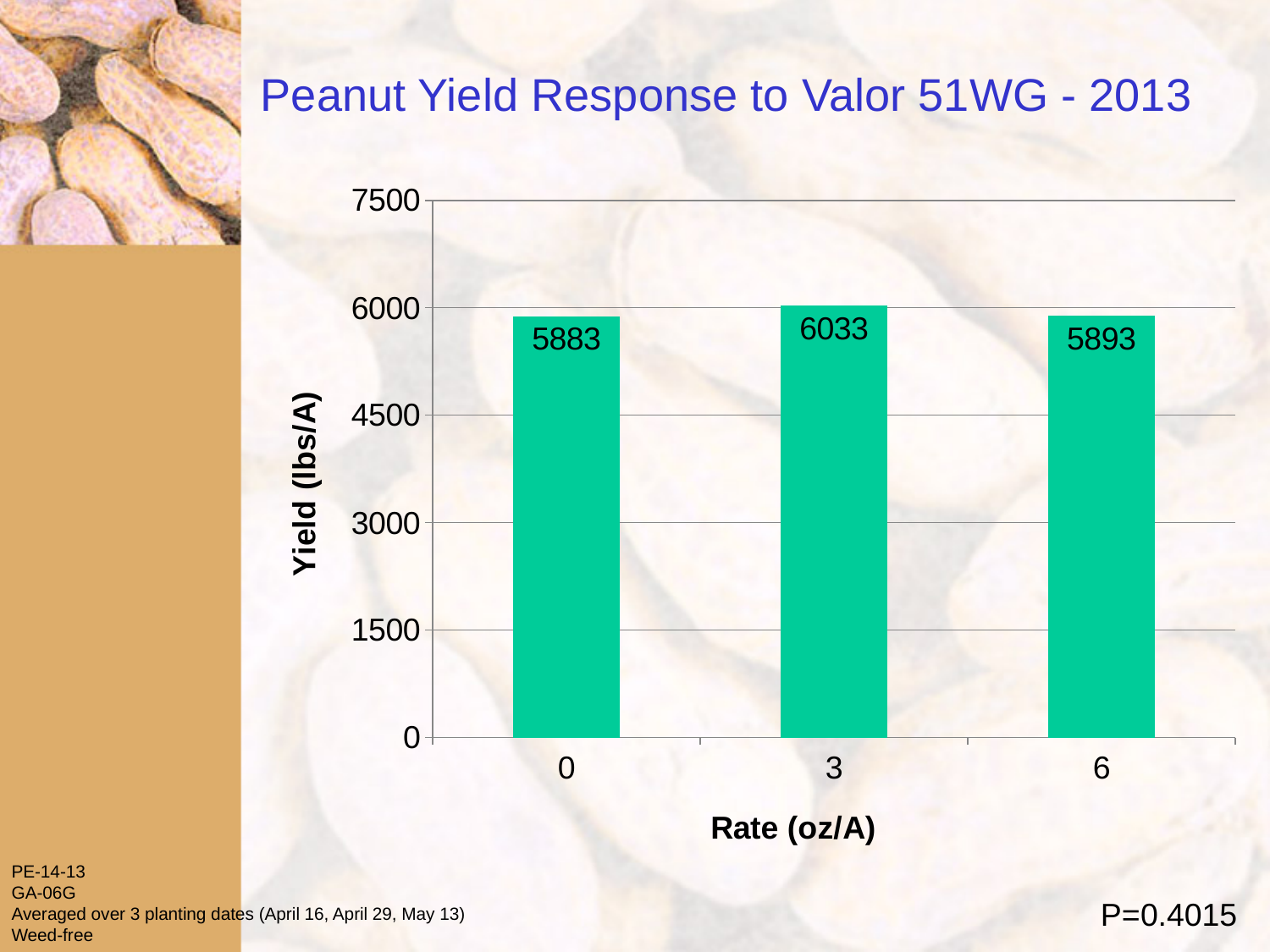
What kind of chart is shown on the slide? bar chart What is the yield at a rate of 3 oz/A? 6033 What is the difference in yield between the 3 oz/A rate and the 0 oz/A rate? 150 What is the title of the chart? Peanut Yield Response to Valor 51WG - 2013 Which rate gives the lowest yield? 0 What is the yield at a rate of 6 oz/A? 5893 What is the difference in yield between the 6 oz/A rate and the 0 oz/A rate? 10 Which has the larger yield, the 3 oz/A rate or the 6 oz/A rate? 3 oz/A How many rate categories are shown on the x axis? 3 What is the yield at a Valor 51WG rate of 0 oz/A? 5883 Is the yield at the 3 oz/A rate greater or less than 6000? greater Which rate gives the highest yield? 3